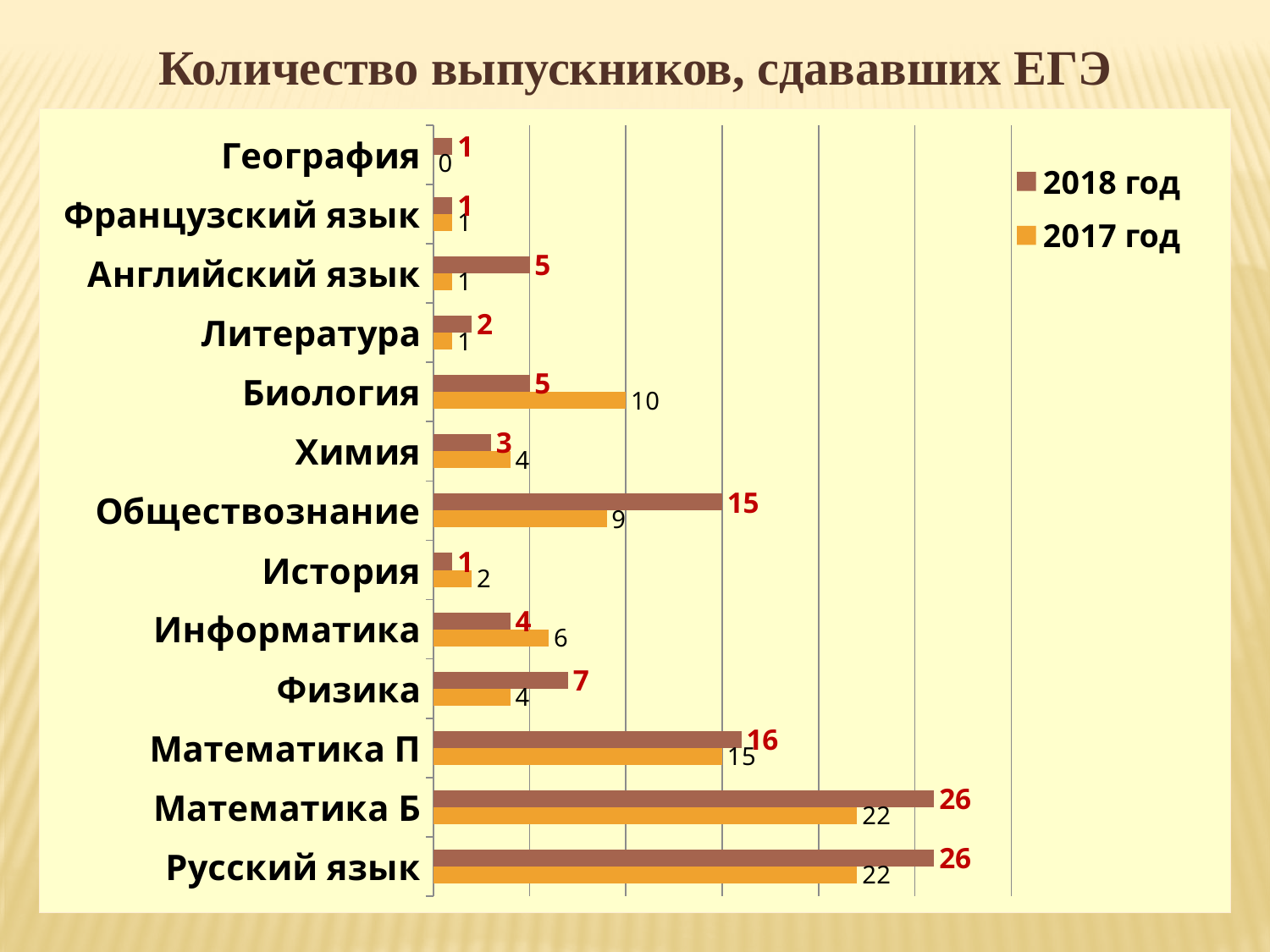
What is the value for География in the 2017 год series? 0 What is the value for Обществознание in the 2018 год series? 15 What is the value for Биология in the 2017 год series? 10 How many subject categories are shown in the chart? 13 How many series does the legend list? 2 Which is larger for Биология: the 2018 год value or the 2017 год value? 2017 год What is the title of the chart? Количество выпускников, сдававших ЕГЭ What is the difference between the 2018 год and 2017 год values for Математика Б? 4 Which subject has the lowest value in the 2017 год series? География What is the value for Физика in the 2018 год series? 7 What is the difference between the 2018 год and 2017 год values for Обществознание? 6 What type of chart is shown on the slide? bar chart